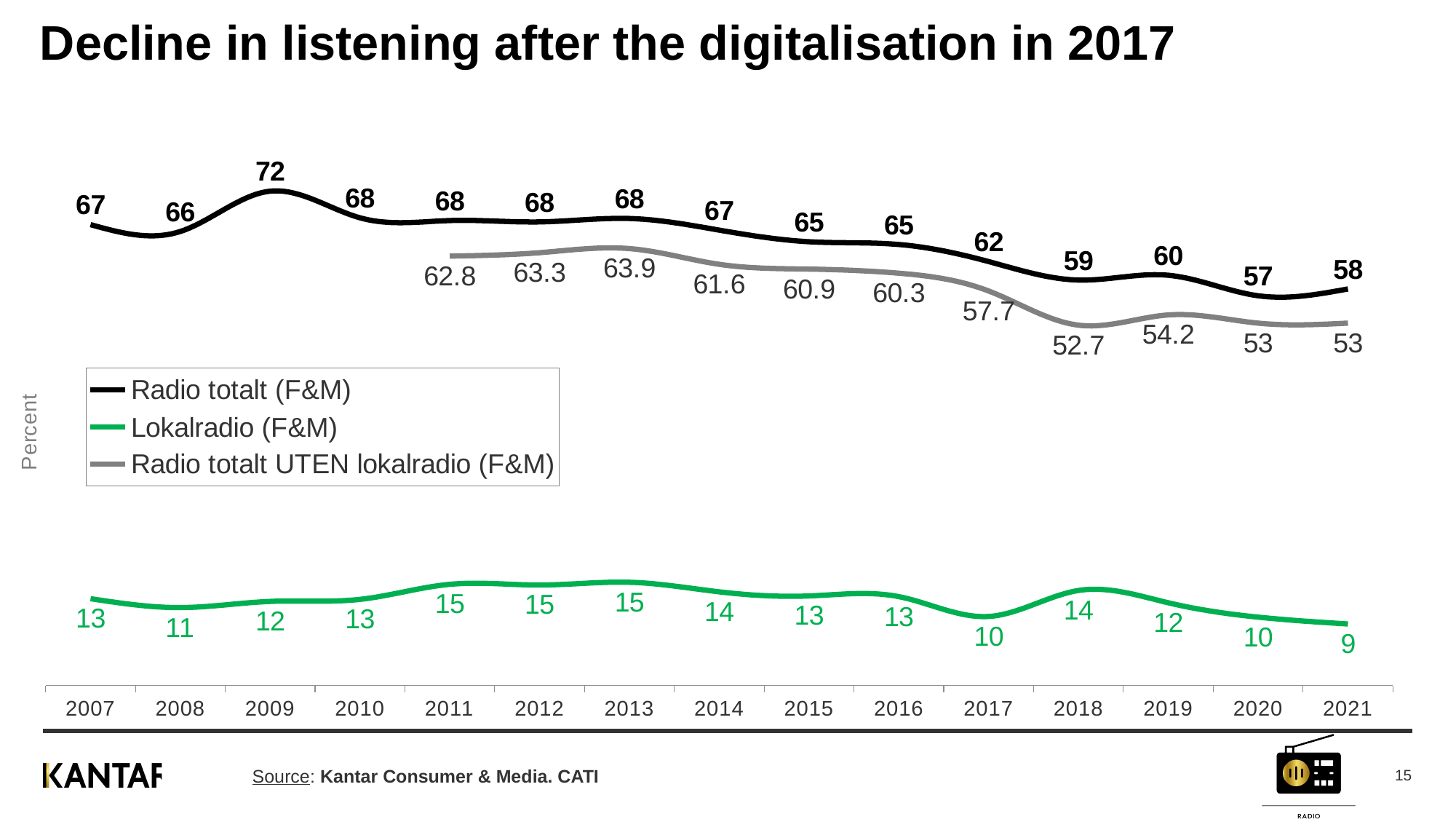
What is the value for Radio totalt (F&M) in 2009? 72 What is the value for Radio totalt UTEN lokalradio (F&M) in 2018? 52.7 What is the value for Lokalradio (F&M) in 2021? 9 Which is larger: Radio totalt UTEN lokalradio (F&M) in 2013 or in 2017? 2013 What is the title of the slide? Decline in listening after the digitalisation in 2017 In which year is Radio totalt (F&M) highest? 2009 What kind of chart is shown on the slide? Line chart What is the difference between Radio totalt (F&M) in 2007 and in 2021? 9 Does Radio totalt (F&M) generally rise or fall from 2013 to 2021? Fall How many years are shown on the x axis? 15 How many series does the legend list? 3 In which year is Lokalradio (F&M) lowest? 2021